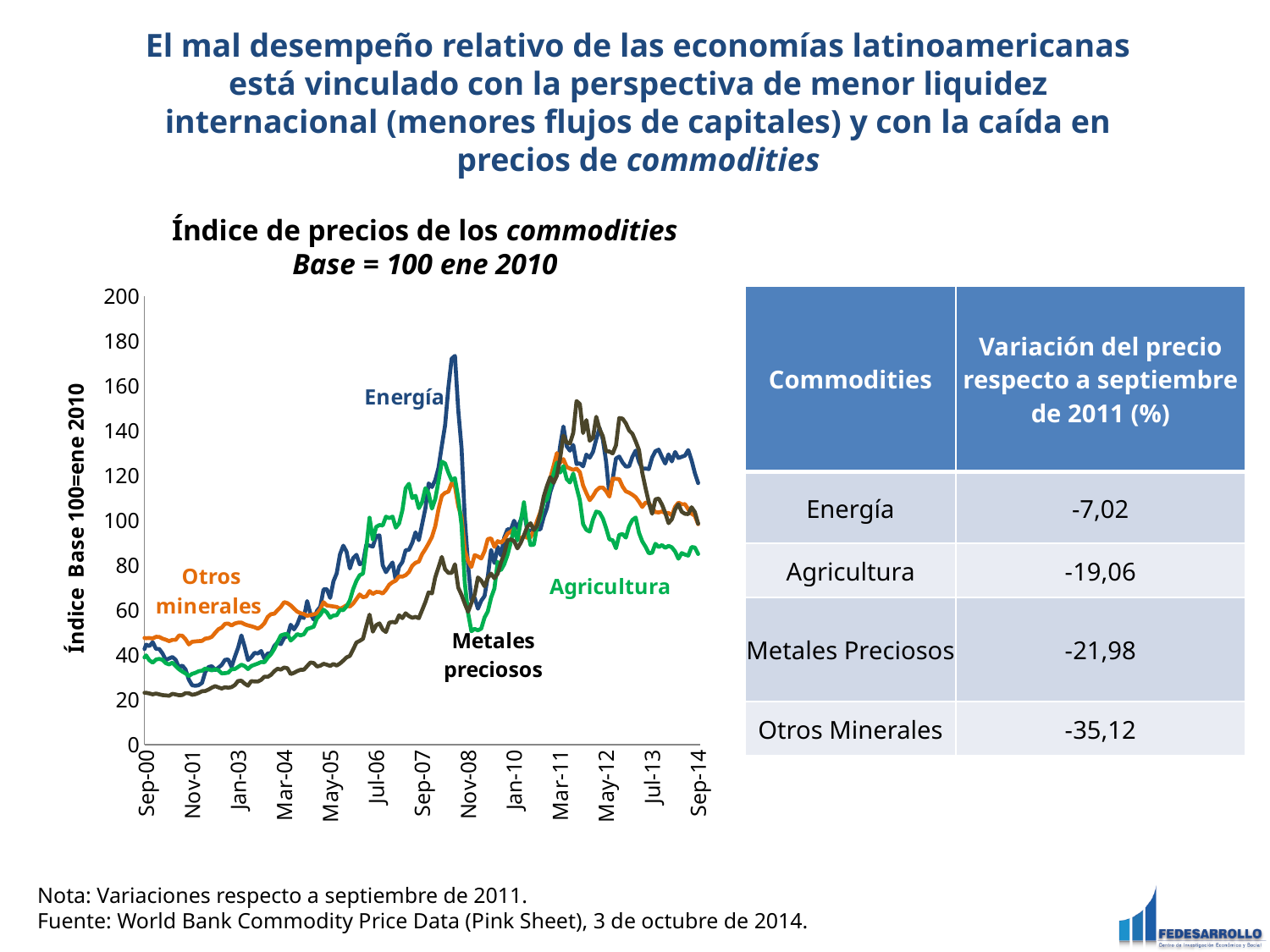
Is the value of Agricultura at Sep-14 greater or less than 100? less Is the value of Energía at Sep-14 greater or less than 100? greater Which series reaches the highest value anywhere on the chart? Energía Does the Metales preciosos series rise or fall between Sep-00 and Mar-11? rise What kind of chart is shown on the slide? line chart What is the title of the chart? Índice de precios de los commodities Base = 100 ene 2010 Is the value of Metales preciosos at Sep-00 greater or less than 40? less How many date labels are shown on the x axis of the chart? 13 How many series are plotted in the commodities price index chart? 4 Which series has the lowest value at Sep-00? Metales preciosos What is the label of the vertical axis of the chart? Índice Base 100=ene 2010